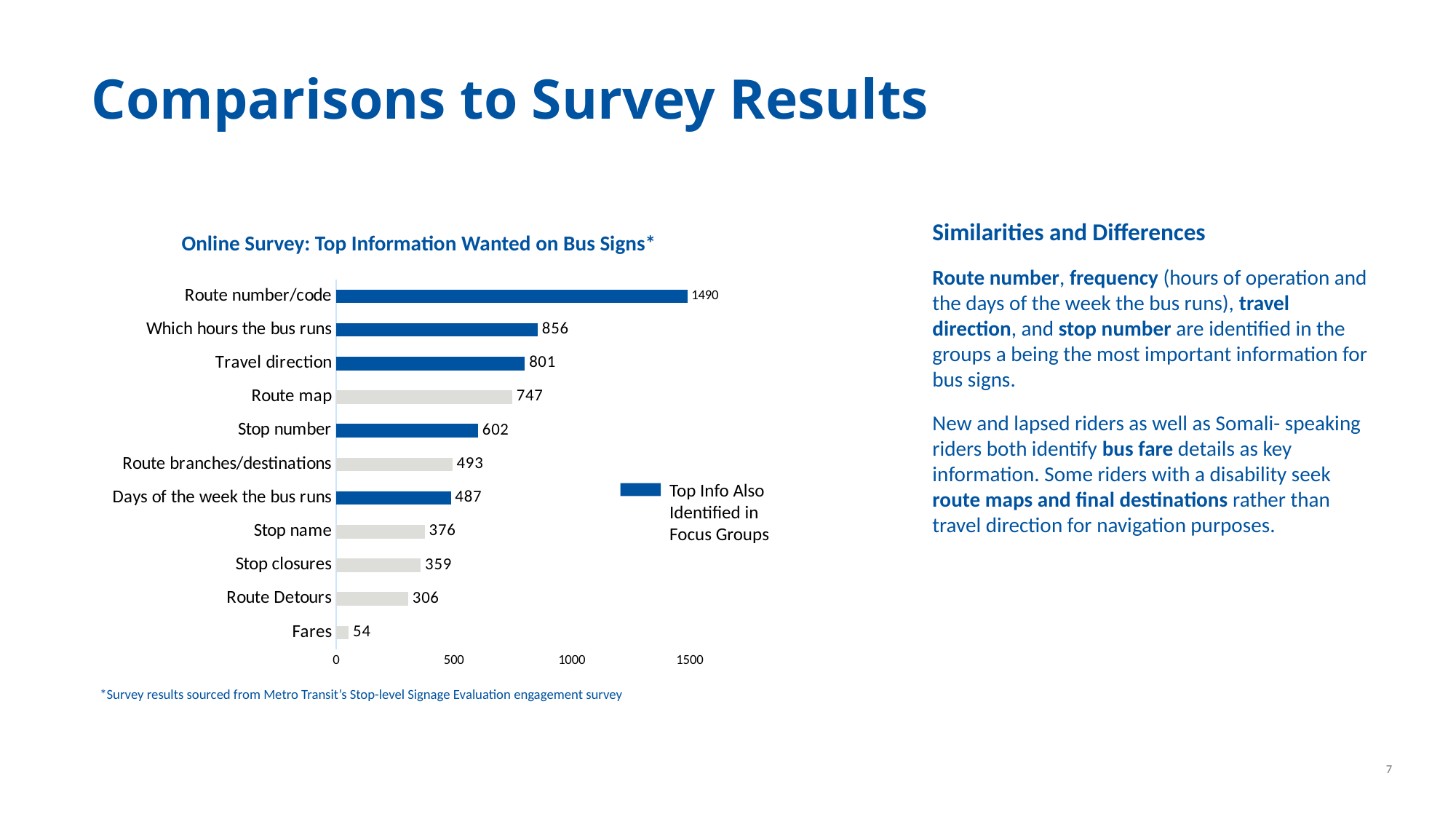
What is the value for Stop closures? 359 What is the difference between the values for Which hours the bus runs and Travel direction? 55 How many categories are shown in the chart? 11 What is the value for Route number/code? 1490 What does the legend say the dark blue bars represent? Top Info Also Identified in Focus Groups Is the value for Route branches/destinations greater or less than 500? less Which category has the lowest value? Fares What kind of chart is shown on the slide? Bar chart What is the value for Travel direction? 801 What is the title of the chart? Online Survey: Top Information Wanted on Bus Signs* Which category has the highest value? Route number/code Which is larger, the value for Route map or the value for Stop number? Route map